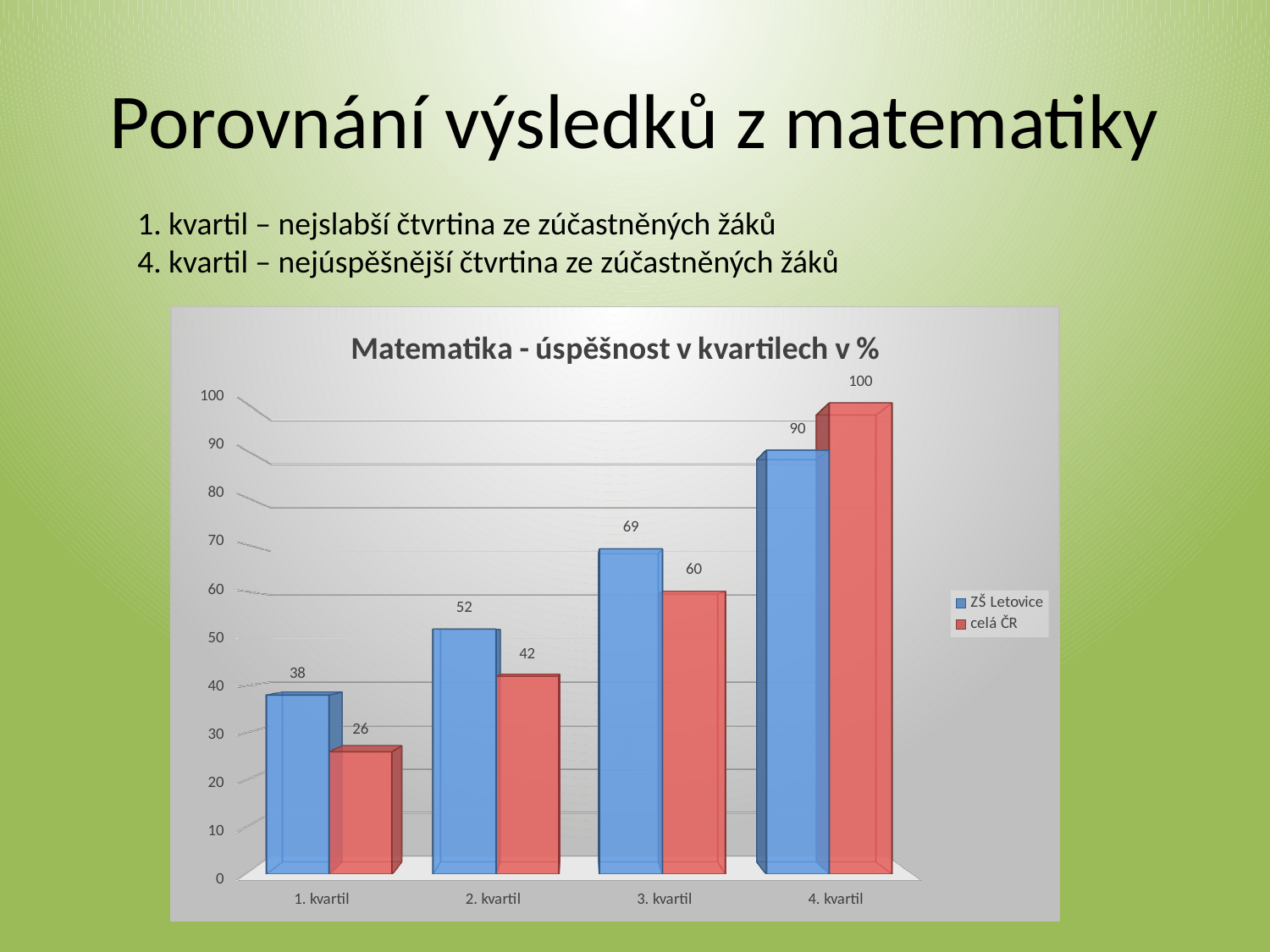
How many categories are shown on the x axis? 4 What is the difference between ZŠ Letovice and celá ČR in 2. kvartil? 10 How many series does the legend list? 2 What is the value for ZŠ Letovice in 1. kvartil? 38 What kind of chart is shown on the slide? bar chart What is the value for celá ČR in 3. kvartil? 60 What is the value for celá ČR in 4. kvartil? 100 Which is larger in 4. kvartil, ZŠ Letovice or celá ČR? celá ČR Which is larger in 3. kvartil, ZŠ Letovice or celá ČR? ZŠ Letovice Which category has the lowest value for celá ČR? 1. kvartil What is the title of the chart? Matematika - úspěšnost v kvartilech v % Which category has the highest value for ZŠ Letovice? 4. kvartil